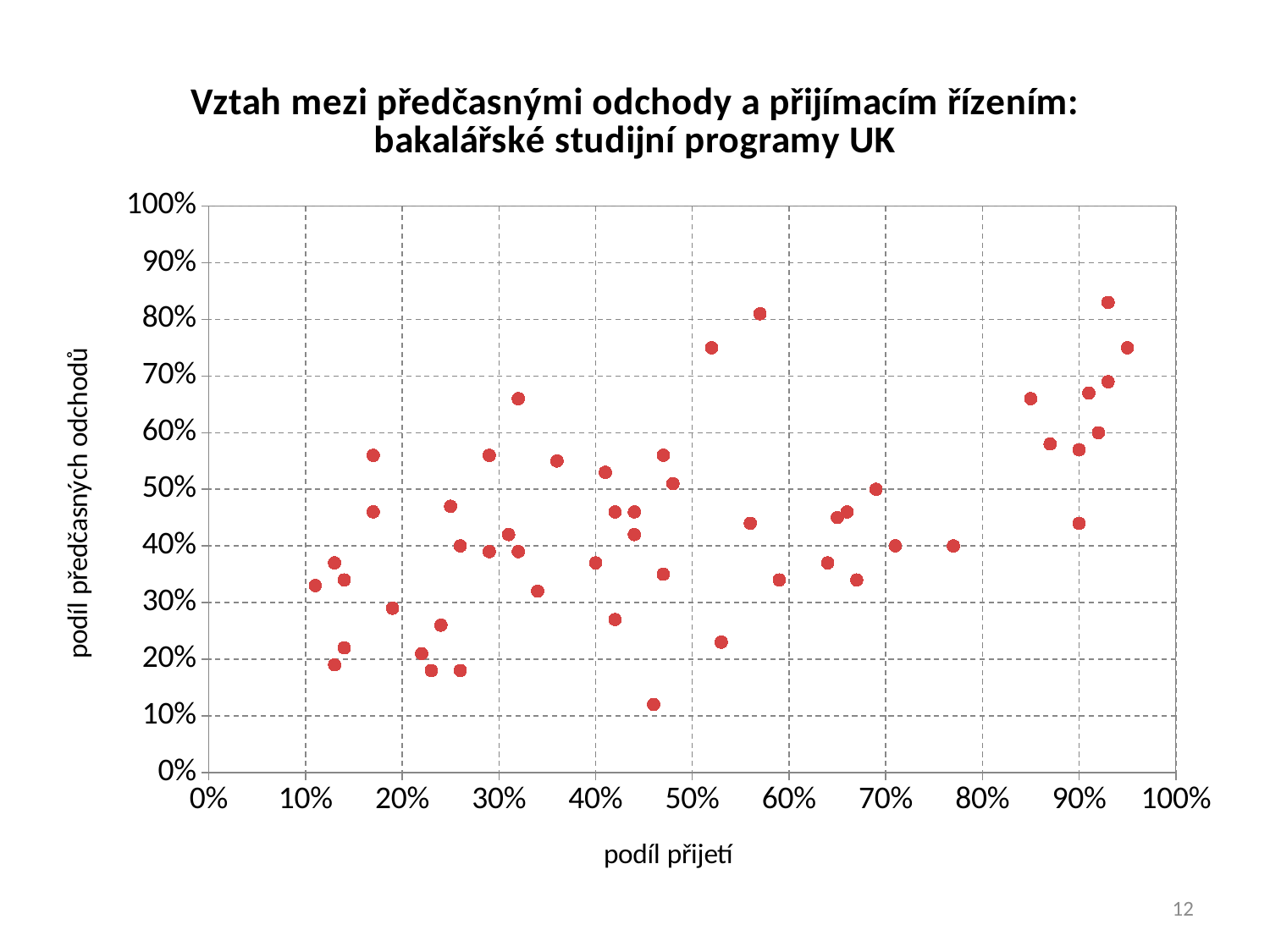
Is the lowest plotted value of podíl předčasných odchodů greater or less than 20%? less What is the title of the chart? Vztah mezi předčasnými odchody a přijímacím řízením: bakalářské studijní programy UK Is the point with the highest podíl přijetí greater or less than 90% on the horizontal axis? greater Is the point with the lowest podíl přijetí greater or less than 20% on the horizontal axis? less What is the label of the horizontal axis? podíl přijetí What kind of chart is shown on the slide? scatter chart Do the values of podíl předčasných odchodů generally rise or fall as podíl přijetí increases? rise